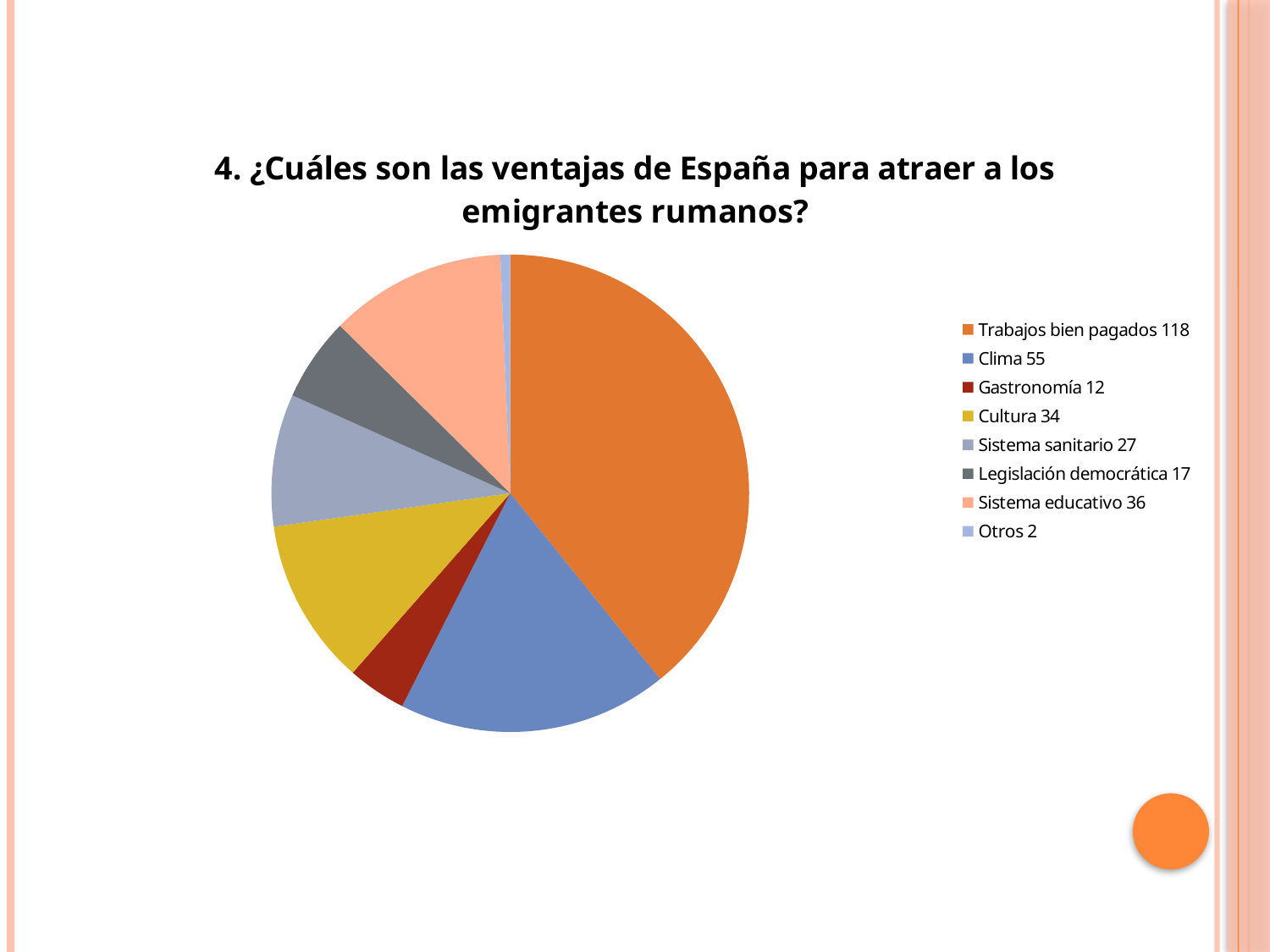
What is the value for Trabajos bien pagados? 118 Which category has the smallest slice of the pie? Otros What is the total of all the values shown in the legend? 301 How many categories does the pie chart have? 8 What is the value for Sistema sanitario? 27 Which category has the largest slice of the pie? Trabajos bien pagados What is the title of the chart? 4. ¿Cuáles son las ventajas de España para atraer a los emigrantes rumanos? Which is larger, the value for Sistema educativo or the value for Cultura? Sistema educativo What is the value for Clima? 55 What is the value for Legislación democrática? 17 What kind of chart is shown on the slide? pie chart What is the difference between the values for Trabajos bien pagados and Clima? 63